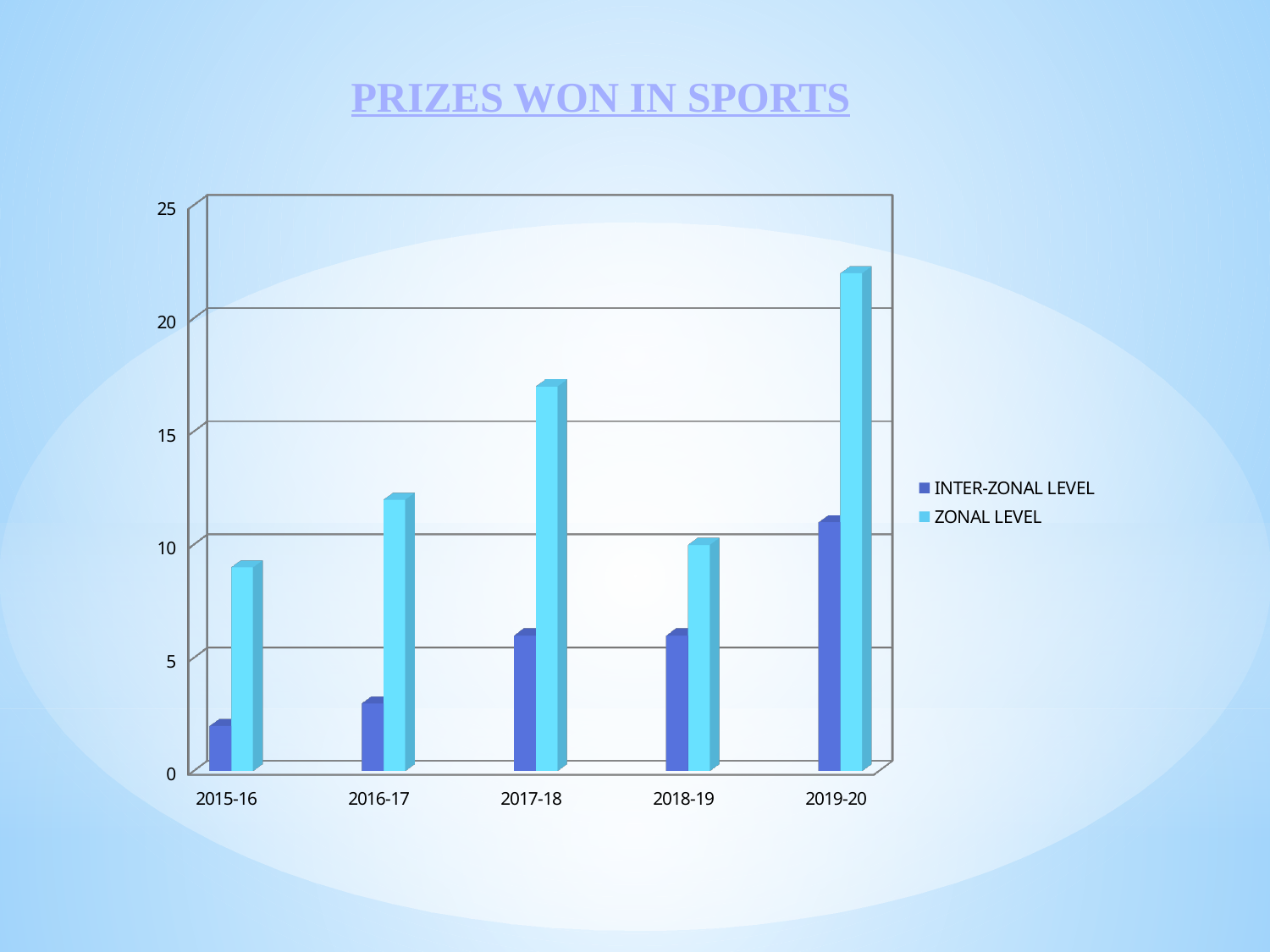
Is the INTER-ZONAL LEVEL value for 2015-16 greater or less than 5? less Which is larger, the ZONAL LEVEL value for 2017-18 or for 2016-17? 2017-18 Is the ZONAL LEVEL value for 2019-20 greater or less than 20? greater Is the ZONAL LEVEL value for 2015-16 greater or less than 10? less Which year has the highest INTER-ZONAL LEVEL value? 2019-20 What is the title of the chart? PRIZES WON IN SPORTS How many year categories are shown on the x axis? 5 How many series does the legend list? 2 In 2019-20, which series has the larger value, INTER-ZONAL LEVEL or ZONAL LEVEL? ZONAL LEVEL What kind of chart is shown on the slide? bar chart Which year has the highest ZONAL LEVEL value? 2019-20